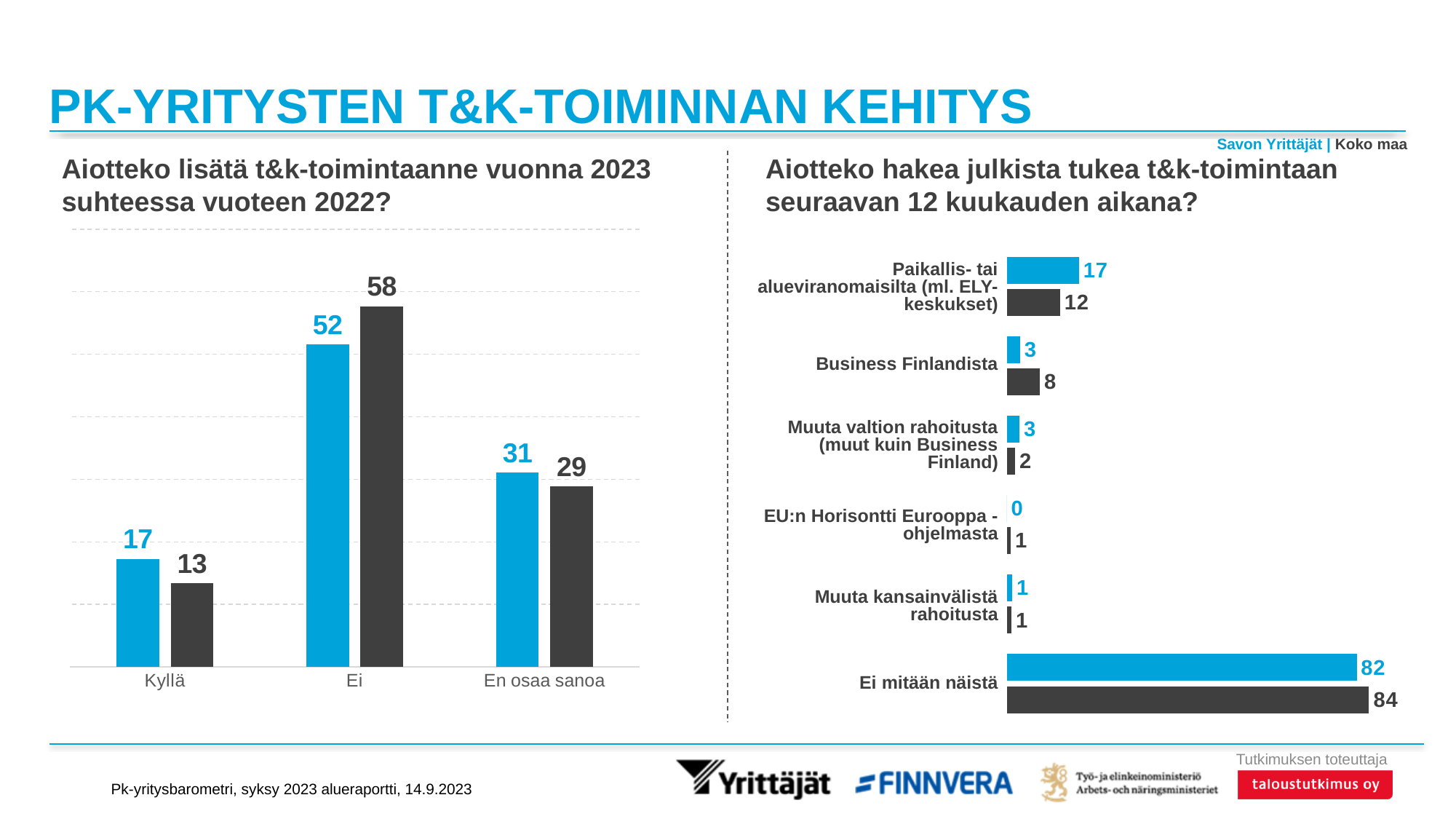
In the right chart (Aiotteko hakea julkista tukea t&k-toimintaan seuraavan 12 kuukauden aikana?), what is the Koko maa value for Ei mitään näistä? 84 In the left chart (Aiotteko lisätä t&k-toimintaanne vuonna 2023 suhteessa vuoteen 2022?), what is the Savon Yrittäjät value for Kyllä? 17 In the left chart, what is the difference between the Koko maa and Savon Yrittäjät values for Ei? 6 In the left chart, which category has the highest Savon Yrittäjät value? Ei In the left chart, how many categories are shown on the x axis? 3 In the right chart, how many categories are listed? 6 In the right chart, which is larger for Paikallis- tai alueviranomaisilta (ml. ELY-keskukset): Savon Yrittäjät or Koko maa? Savon Yrittäjät What type of chart is the left chart? Bar chart In the right chart, what is the Savon Yrittäjät value for Business Finlandista? 3 In the left chart, which category has the lowest Koko maa value? Kyllä How many series does the legend list for the charts on this slide? 2 In the left chart, what is the Koko maa value for Ei? 58